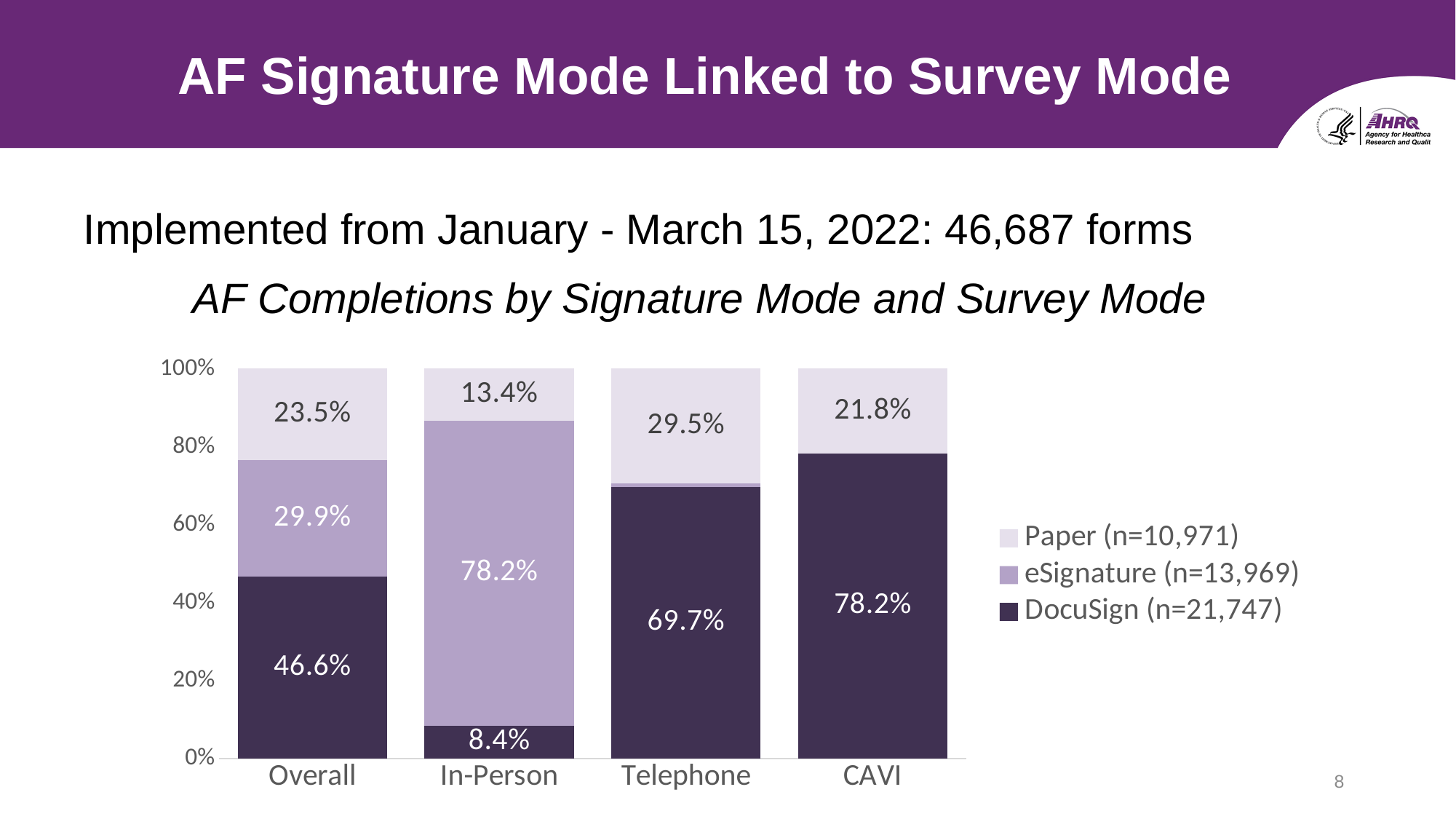
Which is larger, the DocuSign share for Overall or the DocuSign share for Telephone? Telephone How many survey mode categories are shown on the x axis? 4 How many series does the legend list? 3 What is the Paper share for the Overall category? 23.5% Which survey mode has the lowest DocuSign share? In-Person What is the difference between the Paper share for Telephone and the Paper share for In-Person? 16.1% What is the DocuSign share for the Telephone survey mode? 69.7% What is the eSignature share for the In-Person survey mode? 78.2% What is the DocuSign share for CAVI? 78.2% What kind of chart is shown on the slide? Stacked bar chart Is the DocuSign share for CAVI greater or less than 60%? greater Which survey mode has the highest Paper share? Telephone